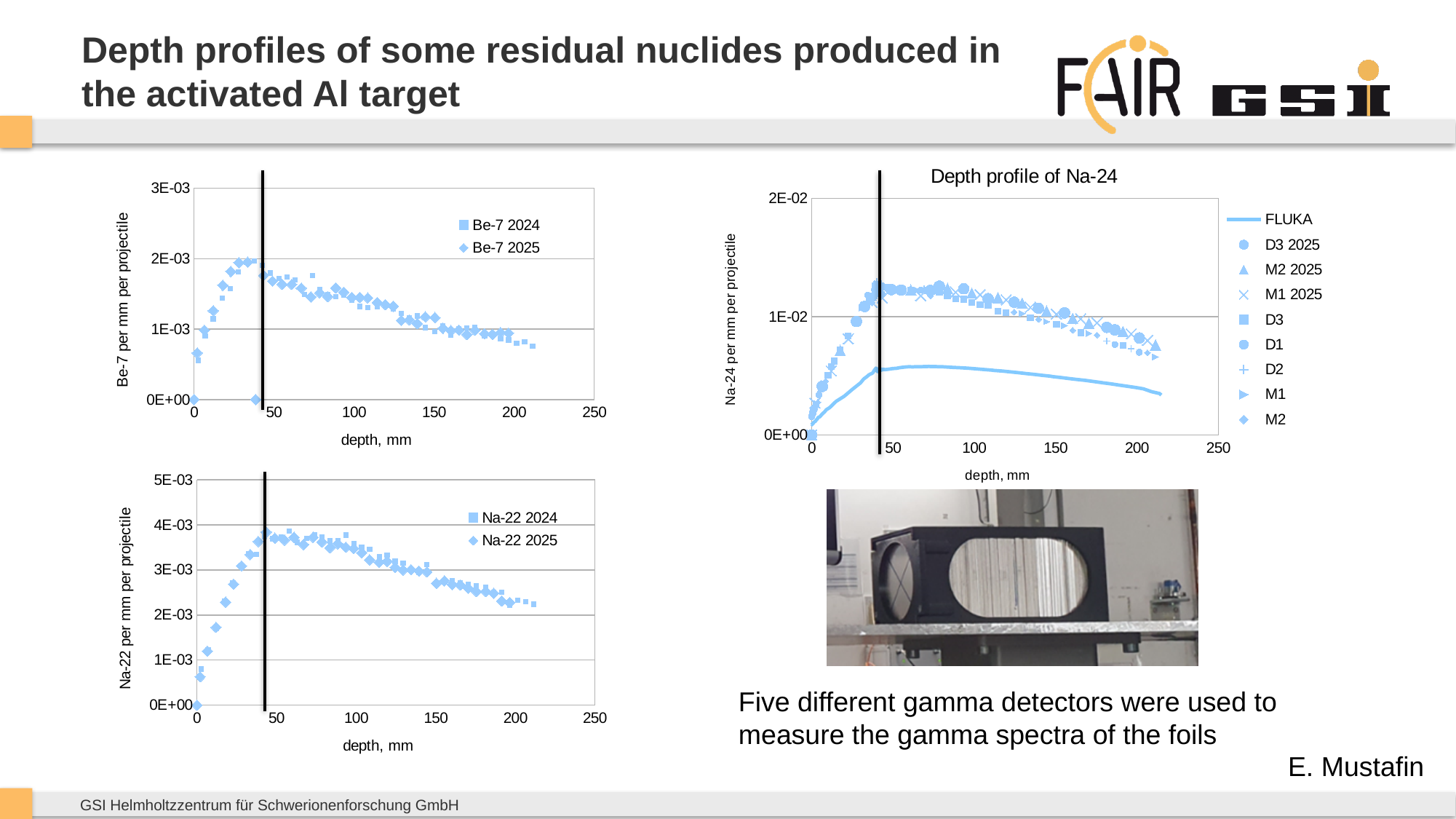
In the bottom-left Na-22 chart, do the values rise or fall as depth increases beyond 50 mm? fall In the bottom-left Na-22 chart, what are the two legend entries? Na-22 2024 and Na-22 2025 In the bottom-left Na-22 chart, is the value at a depth of 100 mm greater or less than 3E-03? greater In the top-left Be-7 chart, do the values rise or fall as depth increases from 0 to 30 mm? rise In the 'Depth profile of Na-24' chart, at a depth of 100 mm, which is higher: the FLUKA curve or the D1 measurements? D1 measurements What kind of chart is the top-left Be-7 chart? Scatter chart In the 'Depth profile of Na-24' chart, how many series does the legend list? 9 What is the title of the chart on the right side of the slide? Depth profile of Na-24 In the top-left Be-7 chart, is the value at a depth of 100 mm greater or less than 1E-03? greater In the bottom-left Na-22 chart, is the value at a depth of 200 mm greater or less than 2E-03? greater In the top-left Be-7 chart, how many series does the legend list? 2